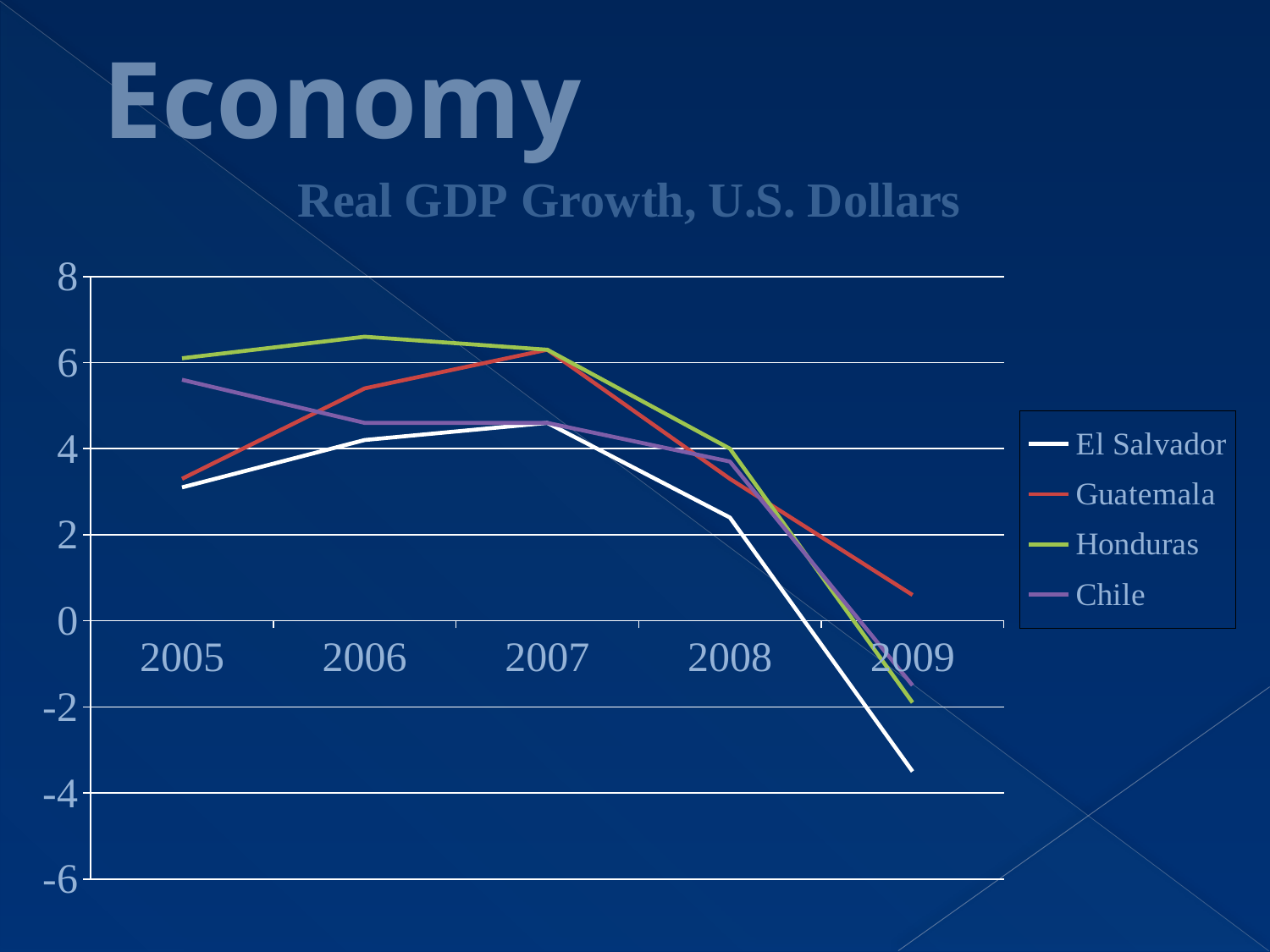
Is the value for El Salvador in 2009 greater or less than -2? less Which country has the lowest value in 2009? El Salvador Which country has the highest value in 2009? Guatemala What is the title of the chart? Real GDP Growth, U.S. Dollars Do the values for El Salvador rise or fall from 2007 to 2009? fall What kind of chart is shown on the slide? line chart Which is larger in 2005, the value for Chile or the value for Guatemala? Chile Which country is represented by the white line? El Salvador Is the value for Honduras in 2006 greater or less than 6? greater How many series does the legend list? 4 How many years are shown on the x axis? 5 Which country has the highest value in 2005? Honduras